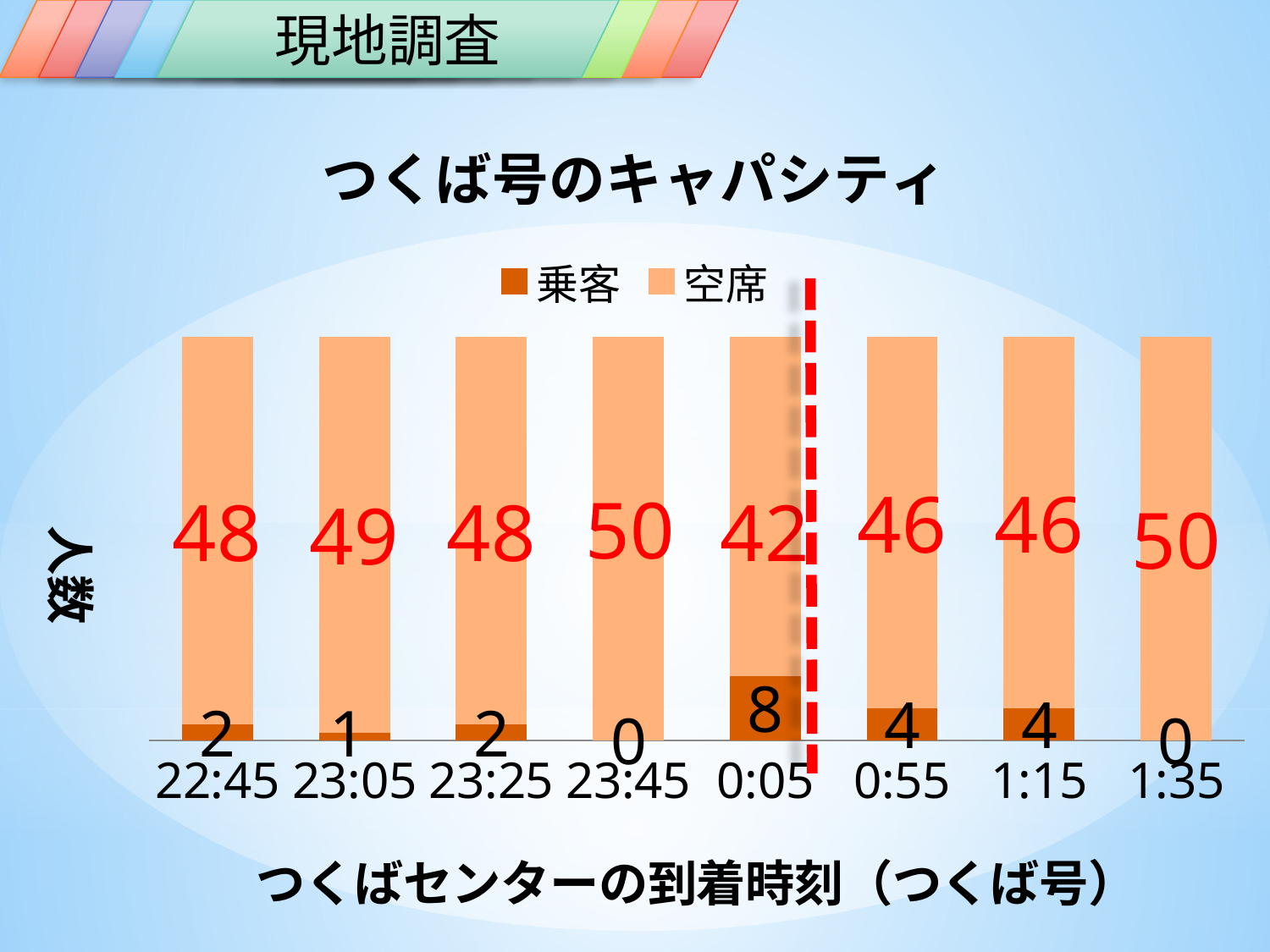
At which arrival time is the 乗客 value highest? 0:05 What is the x-axis title of the chart? つくばセンターの到着時刻（つくば号） What is the 乗客 value at 0:05? 8 At which arrival time is the 空席 value lowest? 0:05 What type of chart is shown on the slide? stacked bar chart How many arrival times are shown on the x axis? 8 What is the 空席 value at 23:05? 49 Which is larger, the 乗客 value at 0:55 or at 23:05? 0:55 How many series does the legend list? 2 What is the total of the stacked bar at 1:15? 50 What is the difference between the 空席 values at 23:45 and 0:05? 8 What is the title of the chart? つくば号のキャパシティ